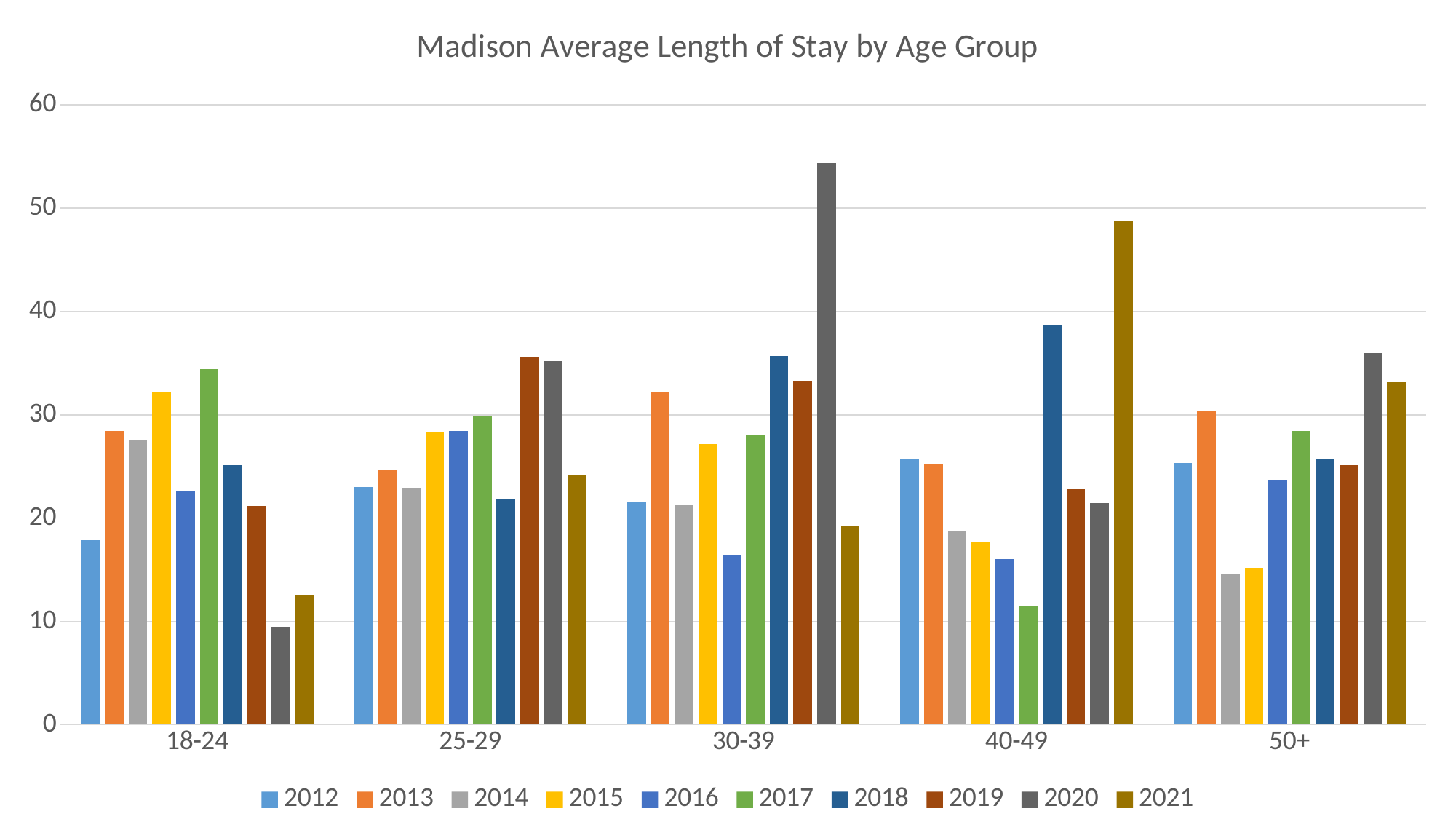
Within the 18-24 age group, which year has the lowest value? 2020 How many series does the legend list? 10 Is the 2017 value for the 40-49 age group greater or less than 20? less Which is larger: the 2021 value for 40-49 or the 2021 value for 50+? 40-49 What is the title of the chart? Madison Average Length of Stay by Age Group Within the 40-49 age group, which year has the lowest value? 2017 Within the 40-49 age group, which year has the highest value? 2021 Which age group has the highest 2020 value? 30-39 What kind of chart is shown on the slide? bar chart Is the 2020 value for the 30-39 age group greater or less than 50? greater How many age groups are shown on the x axis? 5 Is the 2018 value for the 40-49 age group greater or less than 30? greater